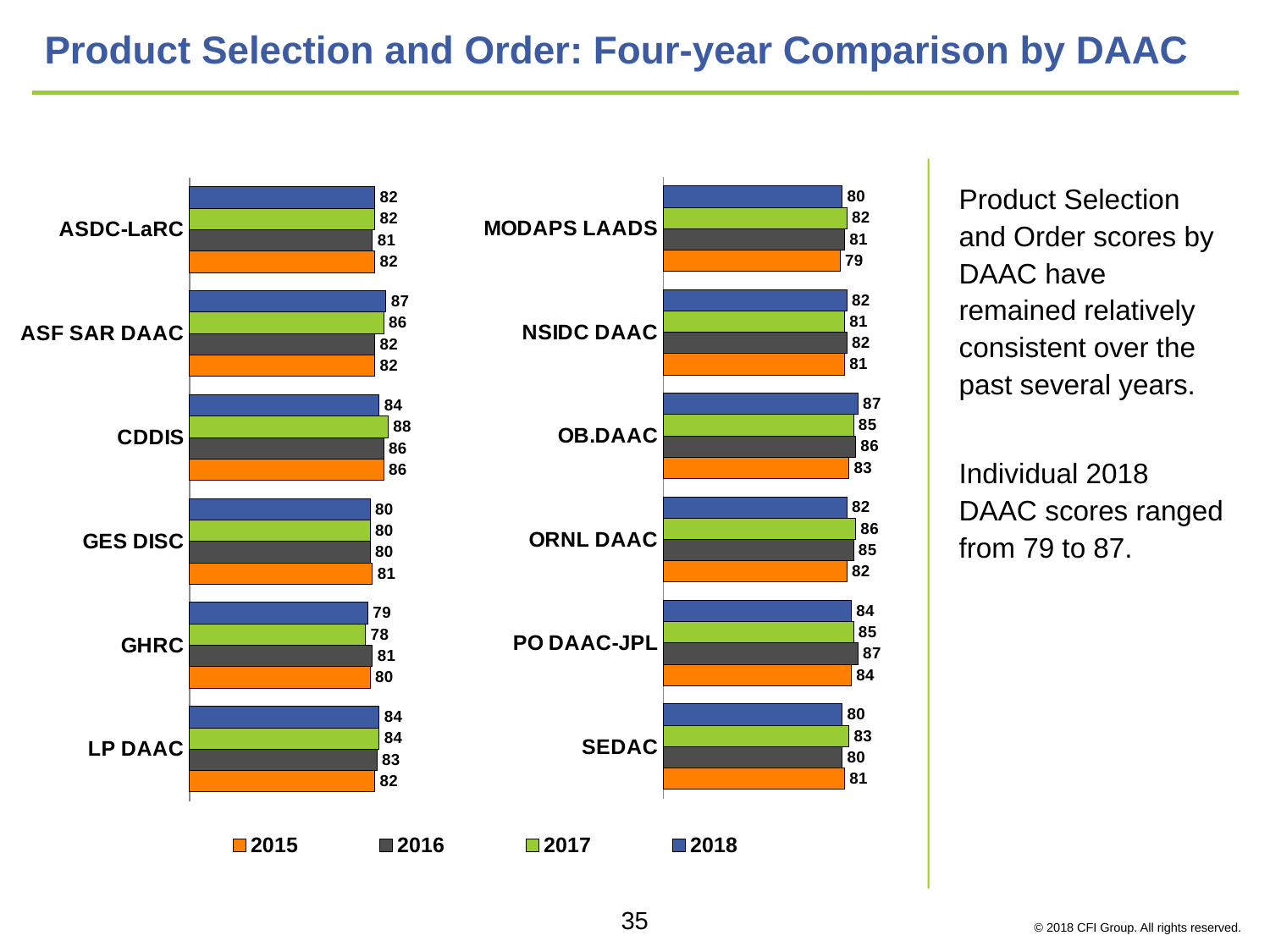
On the left chart, what is the difference between the 2017 and 2018 scores for CDDIS? 4 On the left chart, which DAAC has the lowest 2018 score? GHRC On the right chart, which is larger for ORNL DAAC: the 2017 score or the 2018 score? 2017 On the right chart, which DAAC has the highest 2018 score? OB.DAAC On the left chart, what is the 2018 score for ASF SAR DAAC? 87 On the right chart, what is the 2015 score for MODAPS LAADS? 79 On the right chart, what is the 2016 score for PO DAAC-JPL? 87 How many DAACs are shown on the left chart? 6 On the left chart, what is the 2017 score for CDDIS? 88 How many series does the legend list? 4 On the right chart, what is the difference between the 2018 and 2015 scores for OB.DAAC? 4 What type of chart is used on this slide? Bar chart